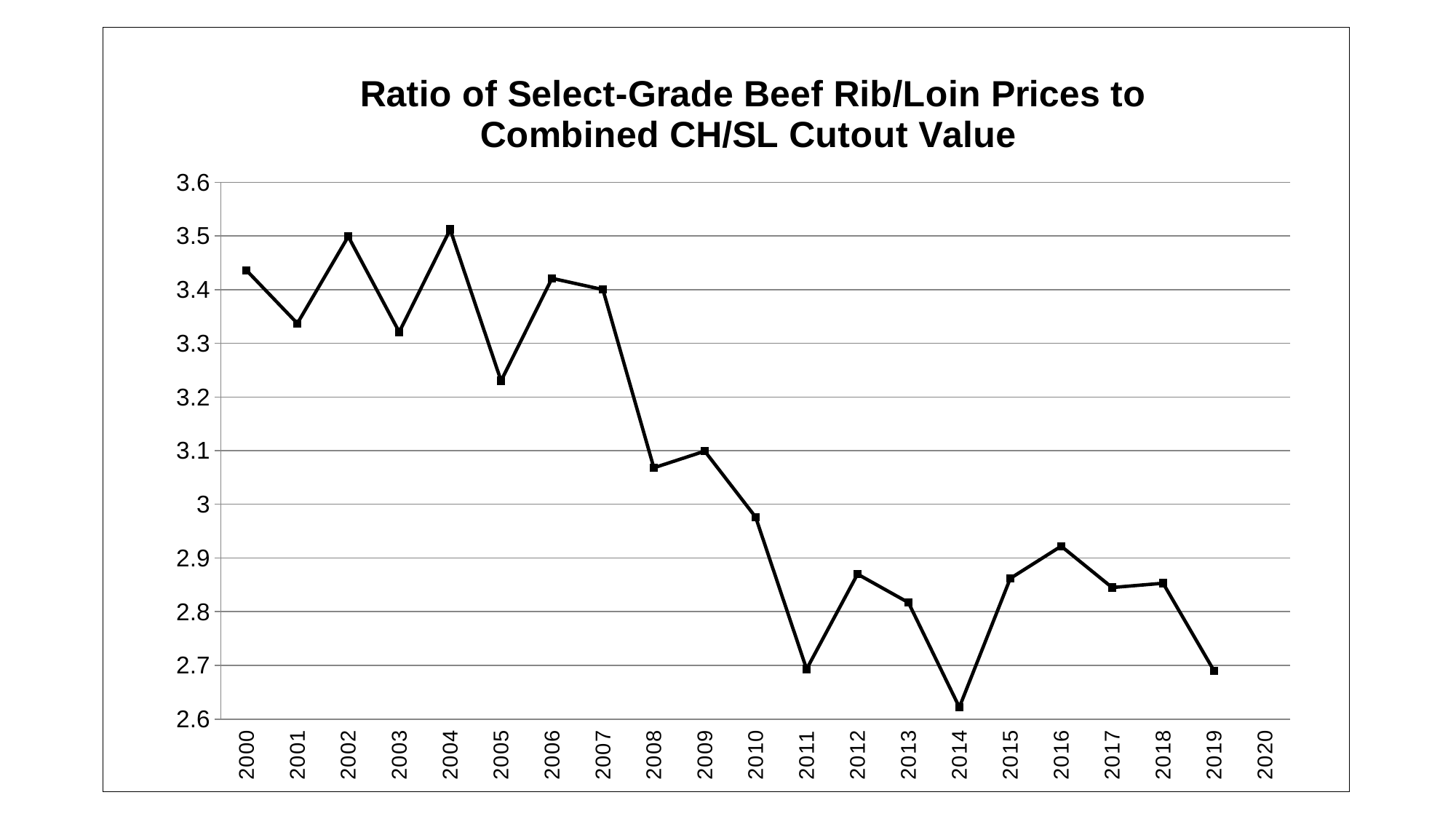
Overall, does the ratio rise or fall from 2000 to 2019? fall Which year has the larger value, 2002 or 2003? 2002 Is the value for 2000 greater or less than 3.4? greater Which year has the larger value, 2016 or 2017? 2016 What is the title of the chart? Ratio of Select-Grade Beef Rib/Loin Prices to Combined CH/SL Cutout Value Is the value for 2014 greater or less than 2.7? less Is the value for 2016 greater or less than 2.9? greater What kind of chart is shown on the slide? line chart How many years have a plotted data point on the chart? 20 Which year has the lowest ratio on the chart? 2014